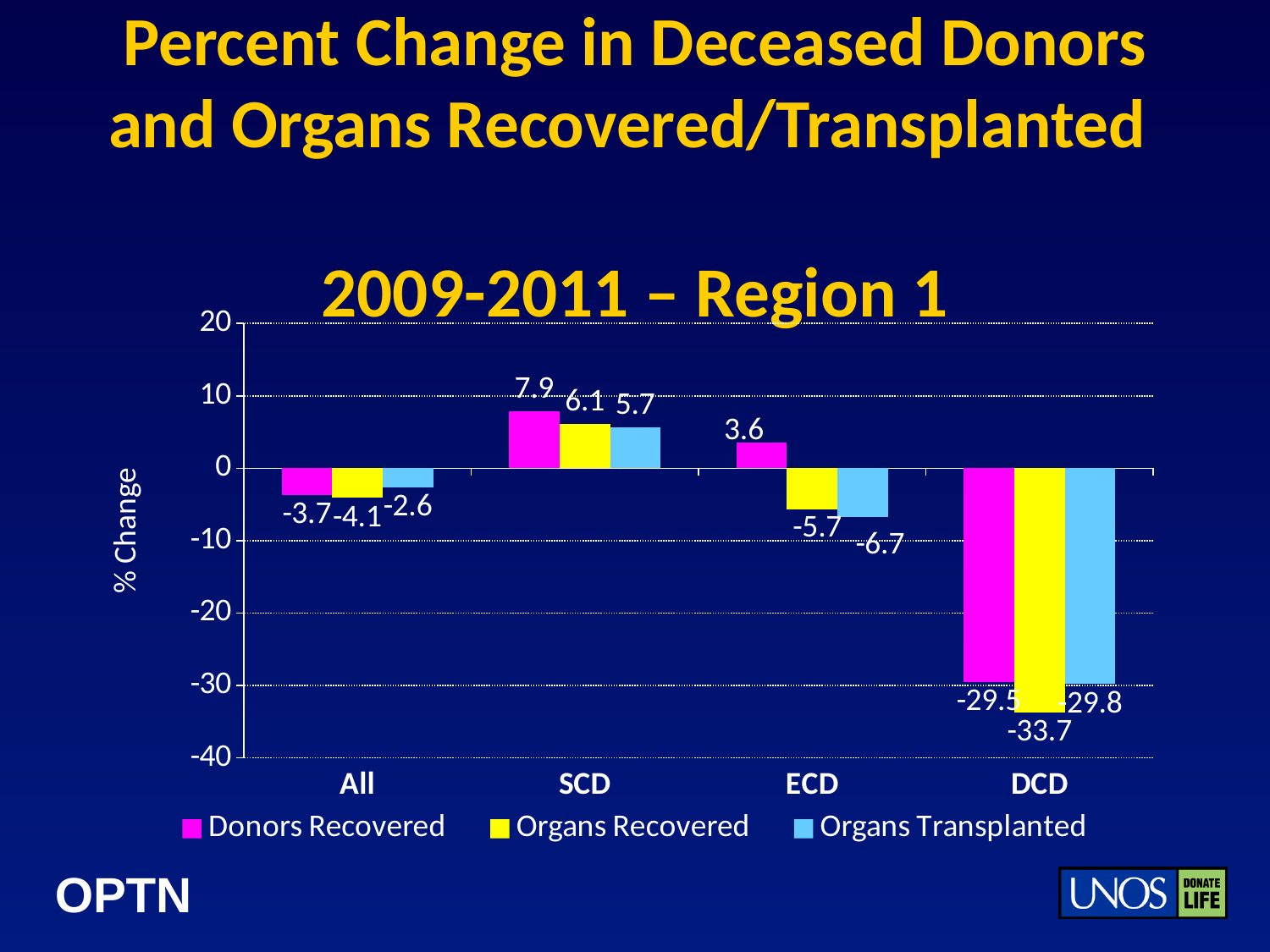
What kind of chart is shown on the slide? Bar chart What is the label of the y axis? % Change What is the difference between the Donors Recovered value and the Organs Transplanted value in the SCD category? 2.2 What is the value for Organs Transplanted in the ECD category? -6.7 What is the value for Organs Transplanted in the All category? -2.6 What is the value for Organs Recovered in the DCD category? -33.7 Which category has the lowest value for Organs Recovered? DCD How many series does the legend list? 3 Which category has the highest value for Donors Recovered? SCD How many categories are shown on the x axis? 4 In the ECD category, which is larger: Donors Recovered or Organs Recovered? Donors Recovered What is the value for Donors Recovered in the SCD category? 7.9